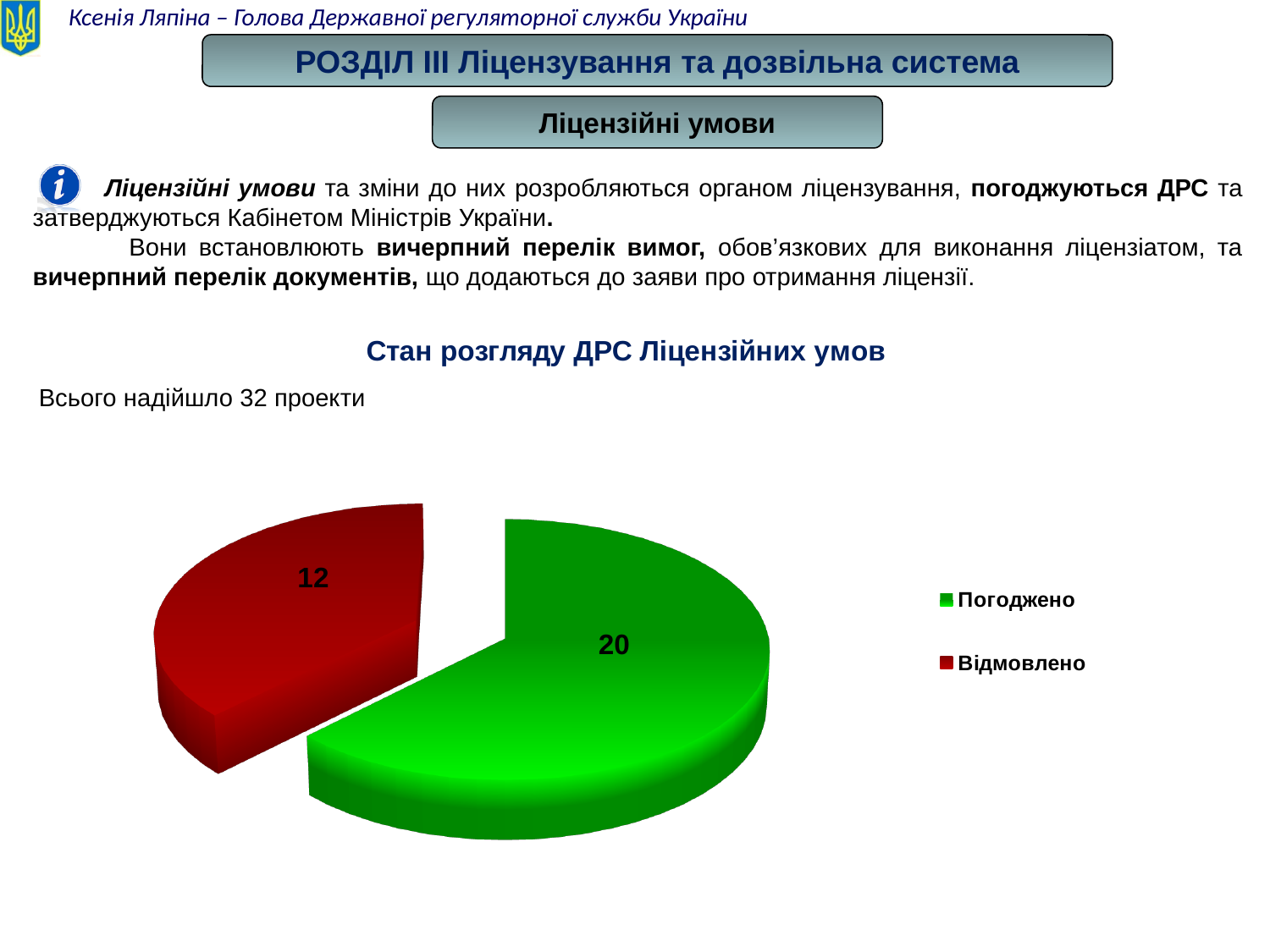
What is the difference between the values for Погоджено and Відмовлено? 8 What is the value for Відмовлено? 12 Which category has the largest slice? Погоджено Which is larger, Погоджено or Відмовлено? Погоджено What is the total of all slices in the pie chart? 32 What colour is the Відмовлено slice? red How many entries does the legend list? 2 What is the value for Погоджено? 20 What share of the pie does Погоджено represent? 62.5% How many slices does the pie chart have? 2 What kind of chart is shown on the slide? pie chart Which category has the smallest slice? Відмовлено